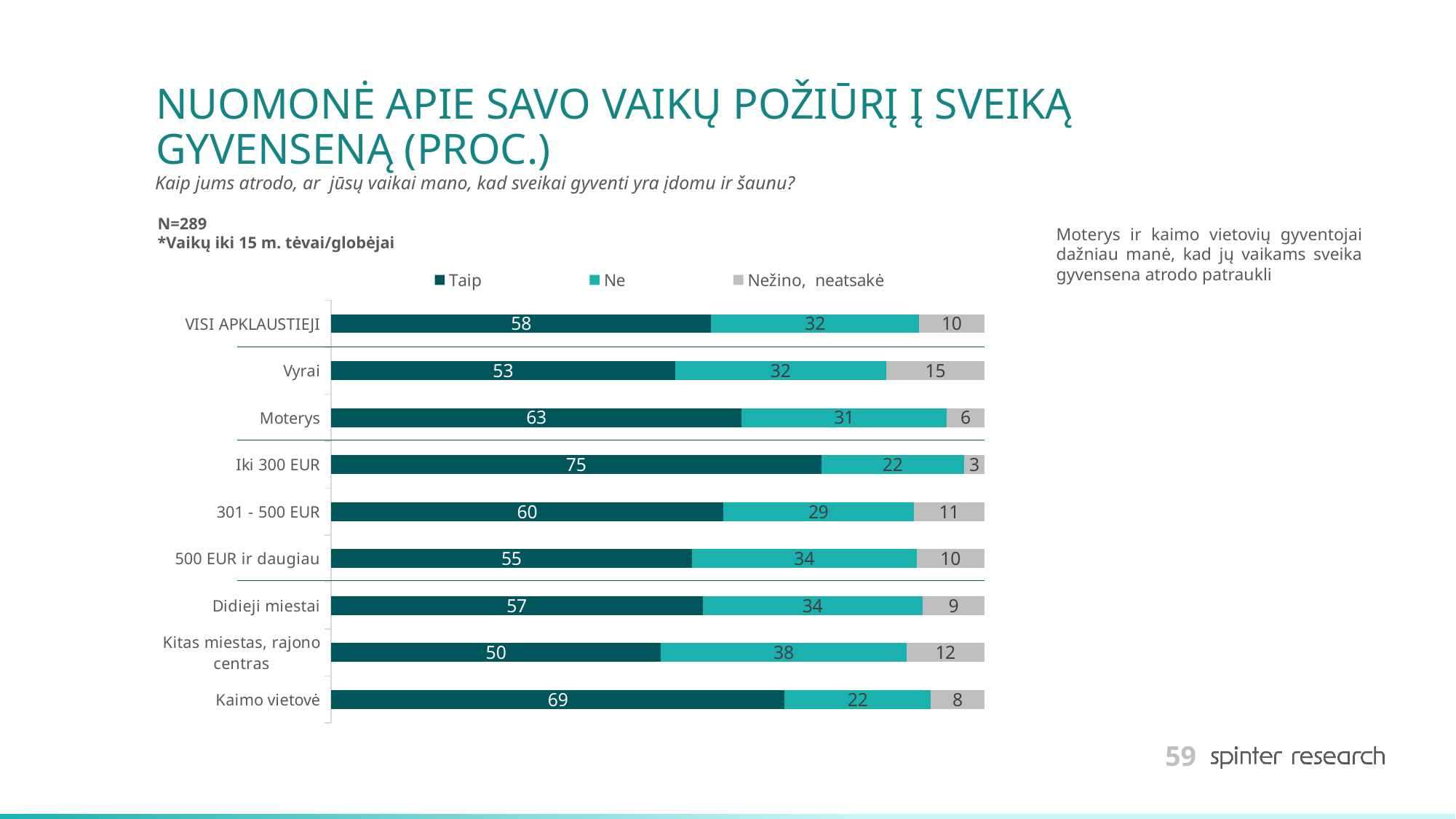
What is the "Ne" value for Kitas miestas, rajono centras? 38 Which is larger, the "Ne" value for 500 EUR ir daugiau or for 301 - 500 EUR? 500 EUR ir daugiau What is the sample size (N) stated on the slide? N=289 Which category has the highest "Taip" value? Iki 300 EUR How many categories are shown on the chart? 9 What is the total of the stacked bar for Iki 300 EUR? 100 What is the "Nežino, neatsakė" value for Vyrai? 15 Which category has the lowest "Taip" value? Kitas miestas, rajono centras How many series does the legend list? 3 What is the difference between the "Taip" values for Kaimo vietovė and Didieji miestai? 12 What kind of chart is shown on the slide? Stacked bar chart What is the "Taip" value for Moterys? 63